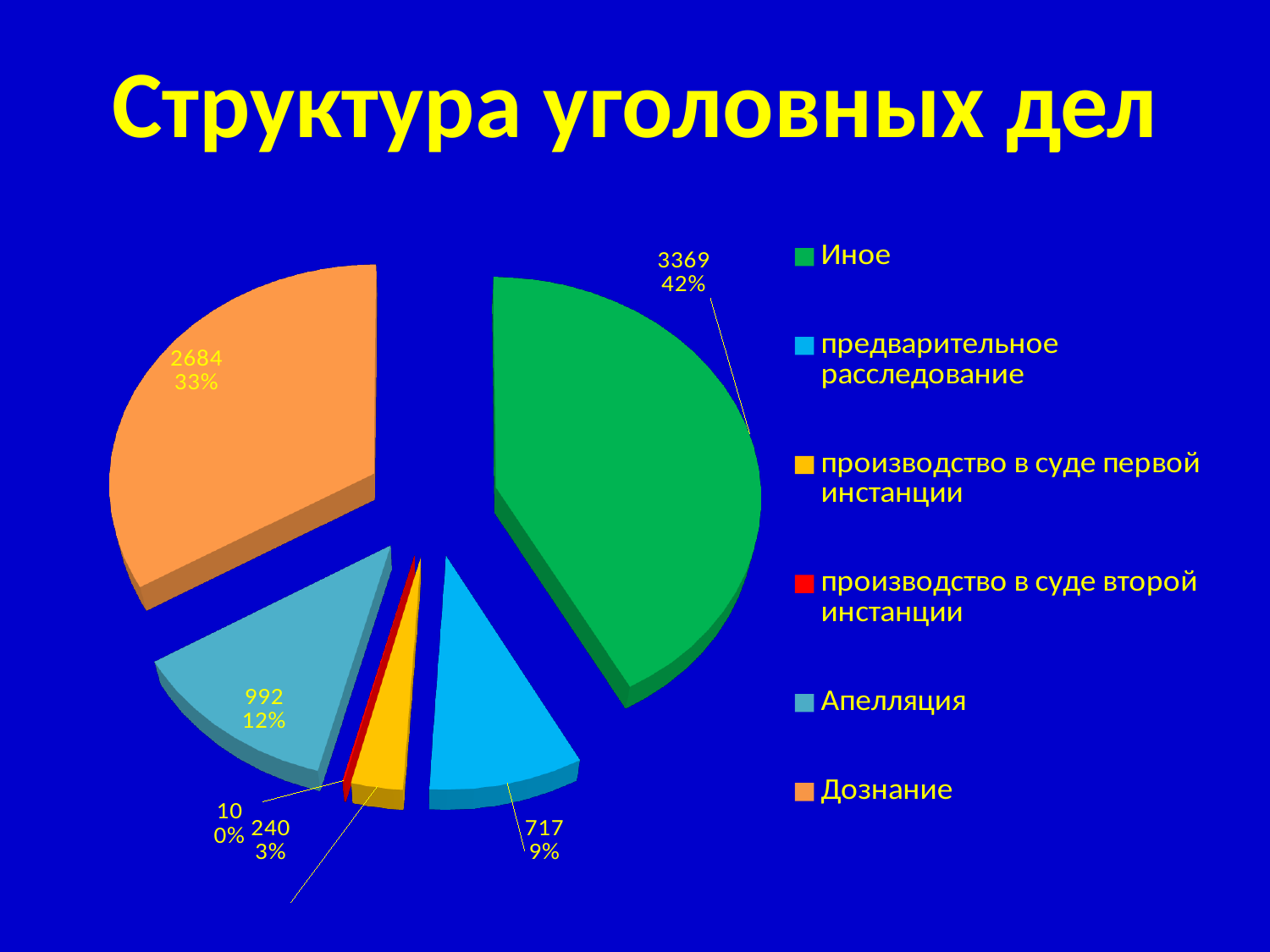
What is the value for Иное? 3369 What is the title of the chart? Структура уголовных дел What is the value for Дознание? 2684 What is the difference between the values for Иное and Дознание? 685 What share of the pie does производство в суде первой инстанции represent? 3% What kind of chart is shown on the slide? pie chart Which category has the smallest slice? производство в суде второй инстанции What is the value for предварительное расследование? 717 Which category has the largest slice? Иное What is the value for Апелляция? 992 What share of the pie does Дознание represent? 33% How many categories does the legend list? 6